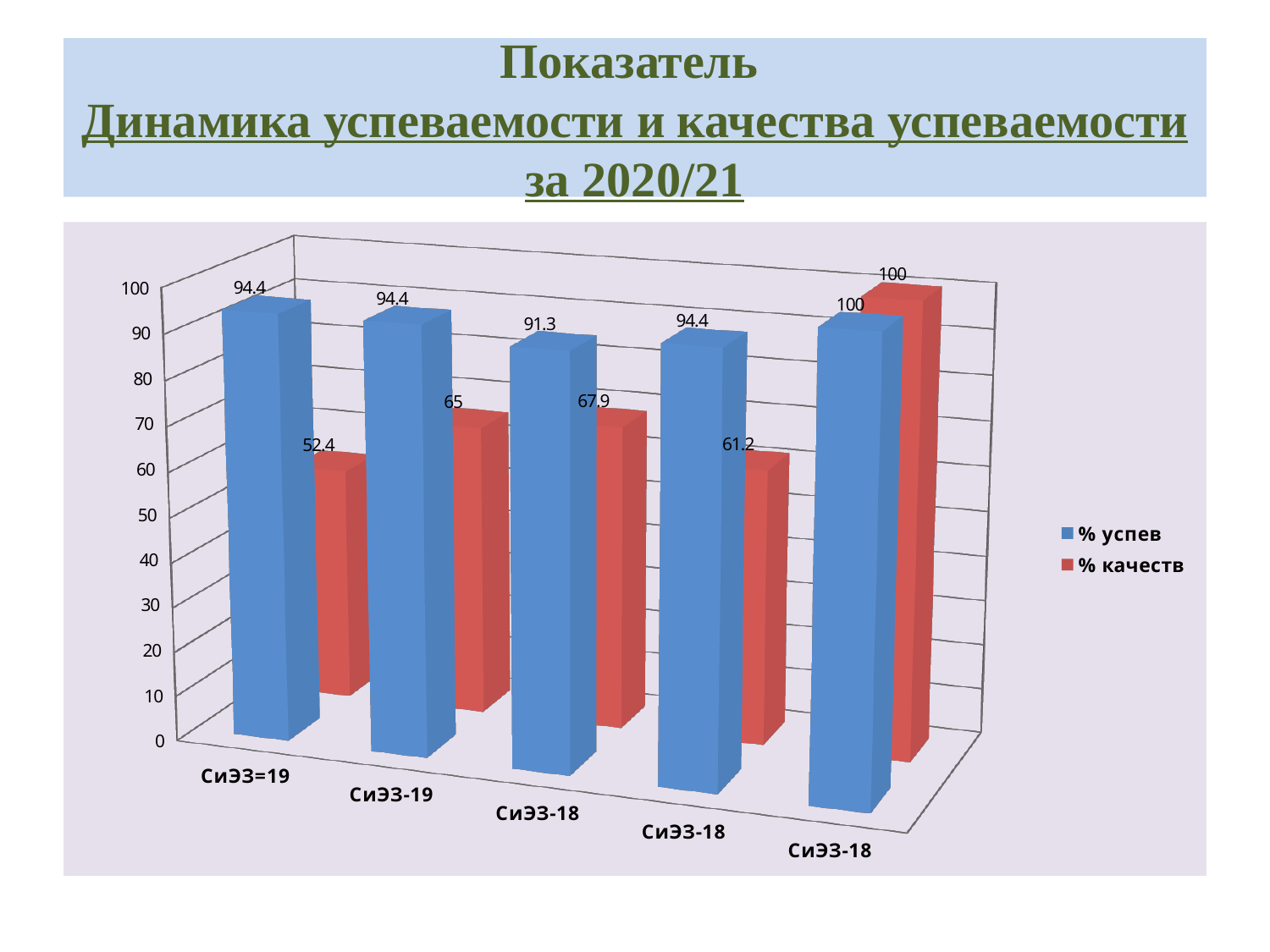
Which category has the lowest % качеств value? СиЭЗ=19 How many series does the legend list? 2 What is the % успев value for the category СиЭЗ=19? 94.4 For the category СиЭЗ=19, how much higher is % успев than % качеств? 42 What is the % качеств value for the third category from the left? 67.9 Which has the larger % качеств value: СиЭЗ-19 or the fourth category from the left? СиЭЗ-19 What is the % качеств value for the first (leftmost) category, СиЭЗ=19? 52.4 How many categories are shown on the x axis? 5 What is the % качеств value for the category СиЭЗ-19? 65 Which category has the lowest % успев value? The third category from the left, СиЭЗ-18 For the category СиЭЗ-19, what is the difference between % успев and % качеств? 29.4 Which category has the highest % качеств value? The fifth (rightmost) category, СиЭЗ-18